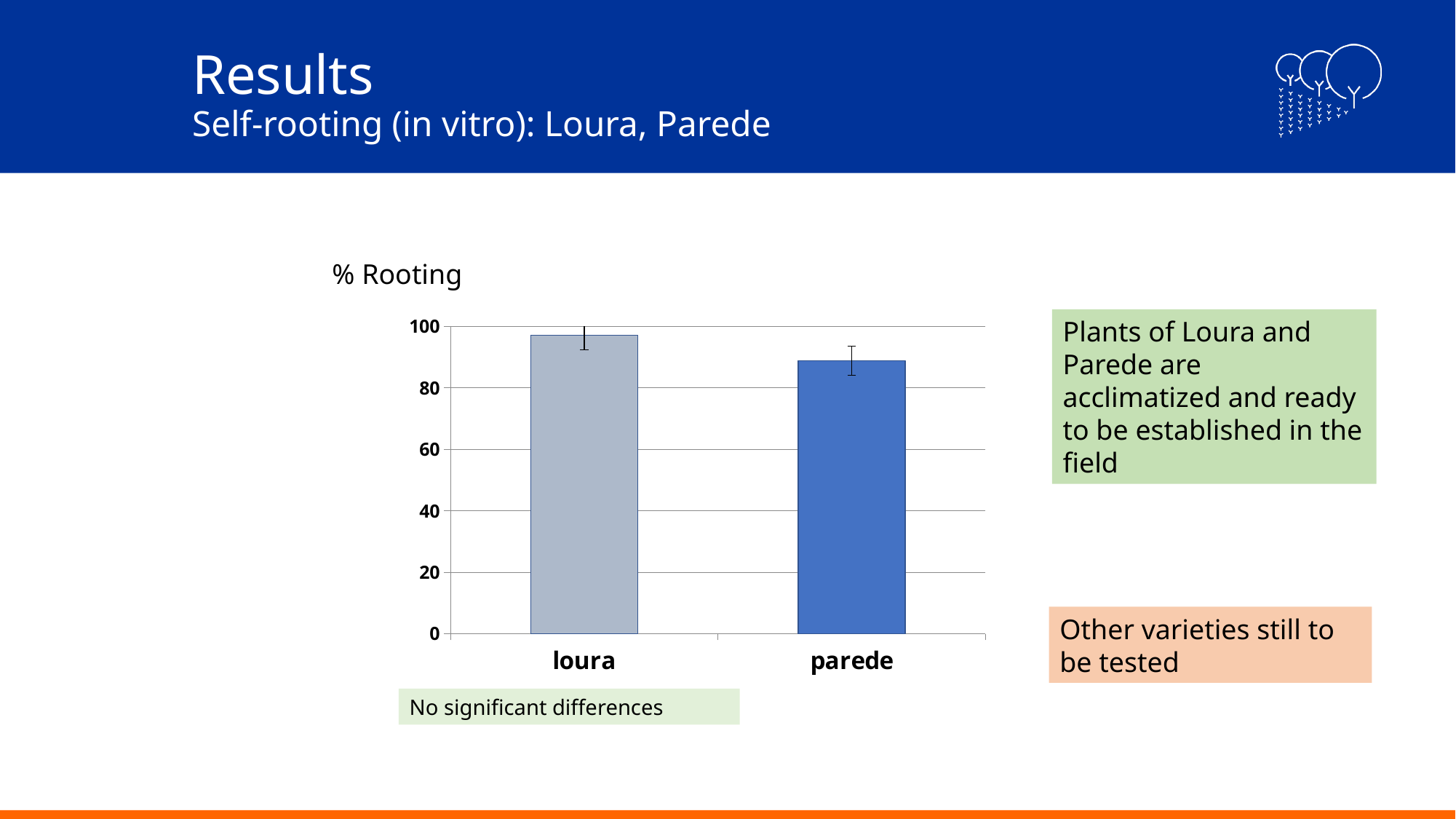
How many categories are plotted in the chart? 2 Is the value for parede greater or less than 80? greater What kind of chart is shown on the slide? bar chart Is the value for loura greater or less than 80? greater Is the value for parede greater or less than 100? less Which has a higher % Rooting, loura or parede? loura What is the highest value shown on the vertical axis of the chart? 100 Which category has the lowest % Rooting? parede Which category has the highest % Rooting? loura What is the title of the chart? % Rooting